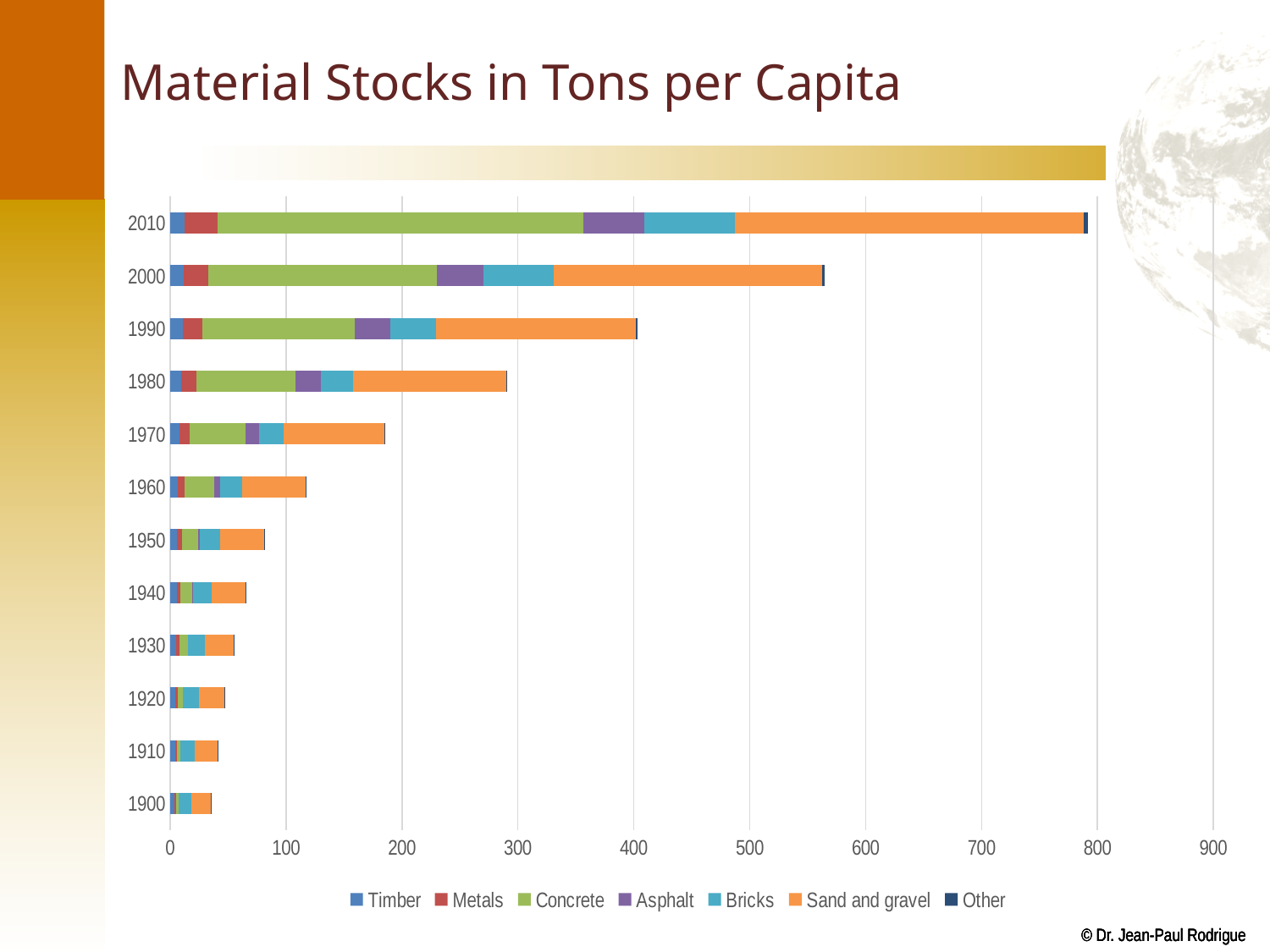
Is the total value for 2010 greater or less than 700? greater Which year has a larger total material stock, 2000 or 1990? 2000 Is the total value for 1950 greater or less than 100? less Which year has the smallest total material stock? 1900 Is the total value for 2000 greater or less than 500? greater What kind of chart is shown on the slide? Stacked bar chart What is the title of the chart? Material Stocks in Tons per Capita Which year has the largest total material stock? 2010 How many years (categories) are plotted on the chart? 12 How many series does the legend list? 7 Do total material stocks rise or fall from 1900 to 2010? Rise